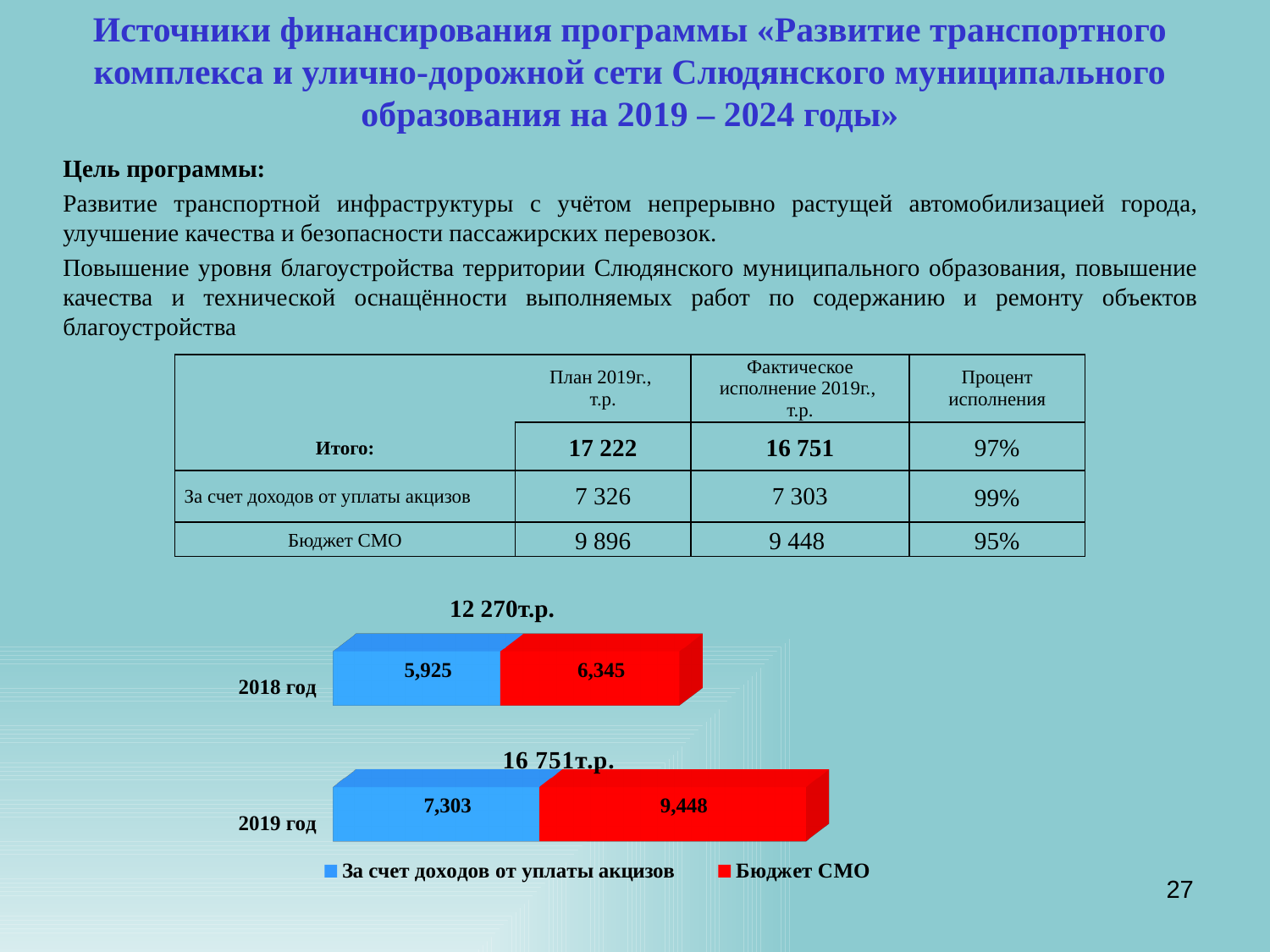
What is the total shown above the stacked bar for 2019 год? 16 751т.р. Which is larger in 2019 год: «За счет доходов от уплаты акцизов» or «Бюджет СМО»? Бюджет СМО What is the difference between the «Бюджет СМО» values for 2019 год and 2018 год? 3,103 What is the total shown above the stacked bar for 2018 год? 12 270т.р. How many categories (years) are plotted in the chart? 2 What is the value for «Бюджет СМО» in 2018 год? 6,345 What kind of chart is shown on the slide? bar chart Which colour represents «Бюджет СМО» in the chart? red What is the value for «За счет доходов от уплаты акцизов» in 2018 год? 5,925 How many series does the chart legend list? 2 What is the value for «Бюджет СМО» in 2019 год? 9,448 What is the value for «За счет доходов от уплаты акцизов» in 2019 год? 7,303